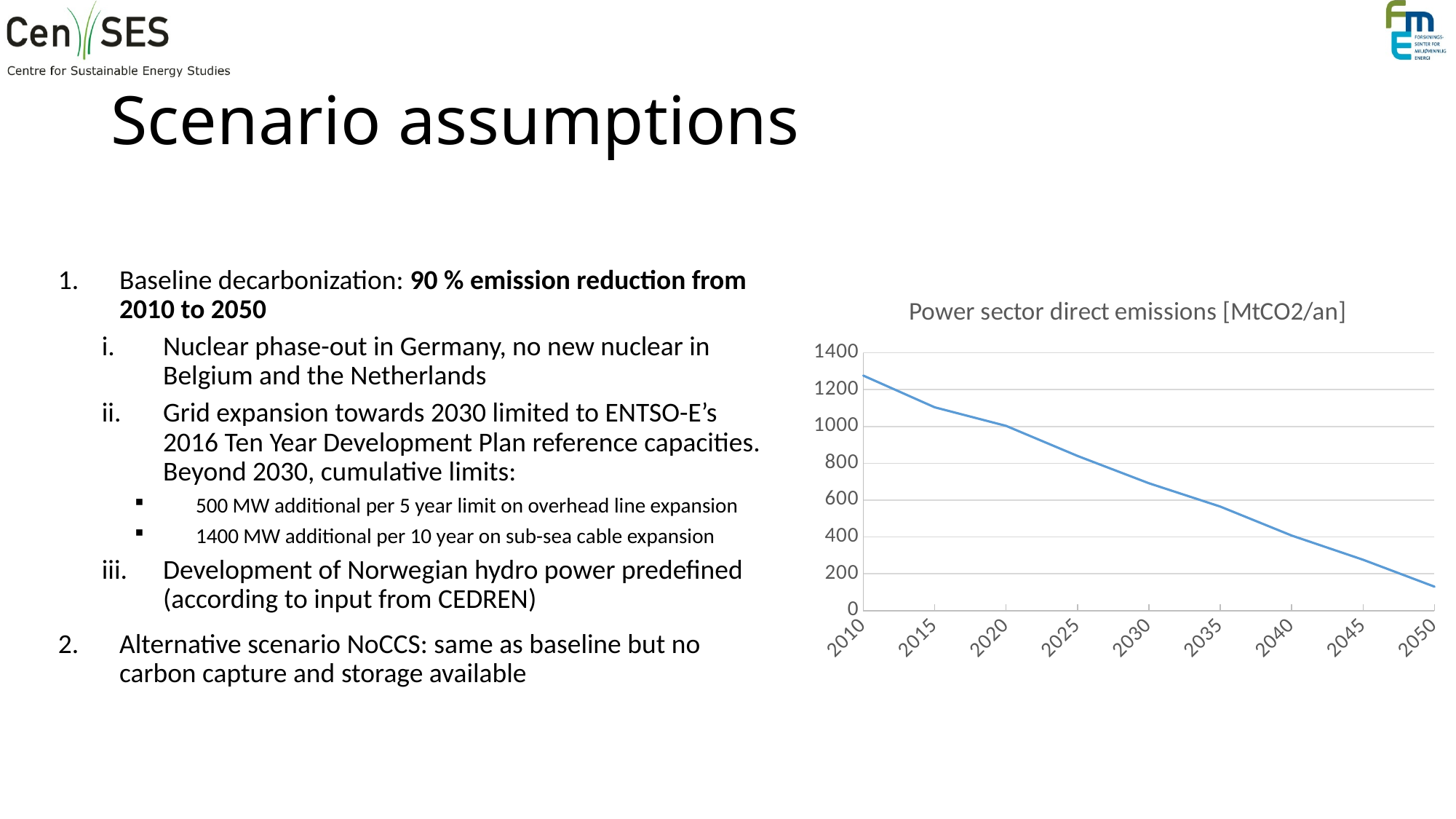
In which year are power sector direct emissions lowest? 2050 Is the value for 2050 greater or less than 200? less Do the power sector direct emissions rise or fall from 2010 to 2050? fall Is the value for 2010 greater or less than 1200? greater In which year are power sector direct emissions highest? 2010 What is the highest value labelled on the y axis? 1400 What kind of chart is shown on the slide? line chart What is the title of the chart? Power sector direct emissions [MtCO2/an] Which year has higher power sector direct emissions, 2020 or 2035? 2020 How many year labels are shown on the x axis? 9 Is the value for 2030 greater or less than 800? less